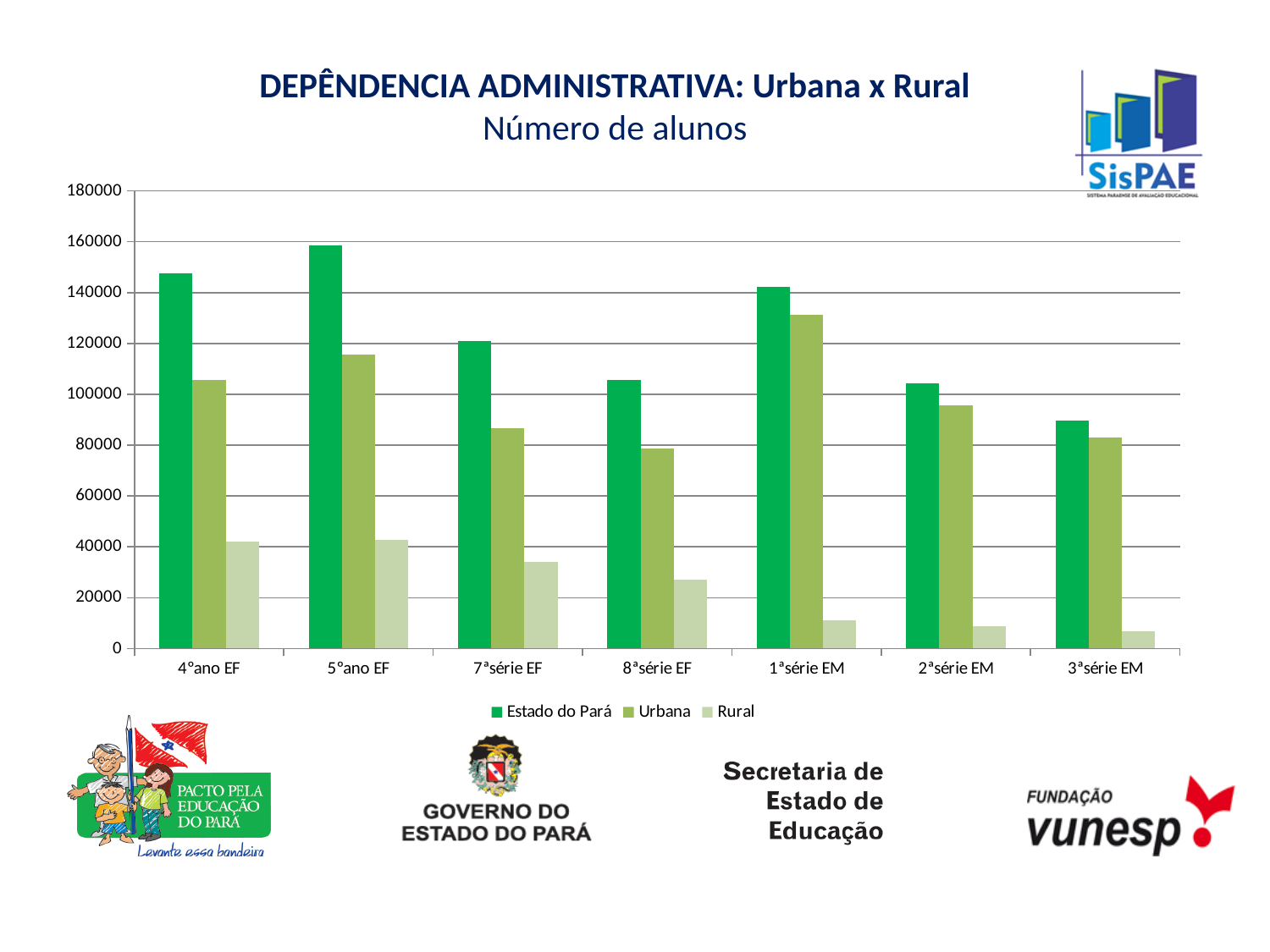
Which is larger: the Urbana value for 5°ano EF or the Urbana value for 7ªsérie EF? 5°ano EF How many categories are shown on the x axis? 7 Which category has the highest value for Estado do Pará? 5°ano EF Is the Urbana value for 1ªsérie EM greater or less than 120000? greater How many series does the legend list? 3 From 5°ano EF to 3ªsérie EM, do the Rural values rise or fall along the x axis? fall Which category has the lowest value for Rural? 3ªsérie EM Which category has the lowest value for Estado do Pará? 3ªsérie EM Which category has the highest value for Urbana? 1ªsérie EM What kind of chart is shown on the slide? bar chart Is the Rural value for 1ªsérie EM greater or less than 20000? less Is the Estado do Pará value for 5°ano EF greater or less than 140000? greater